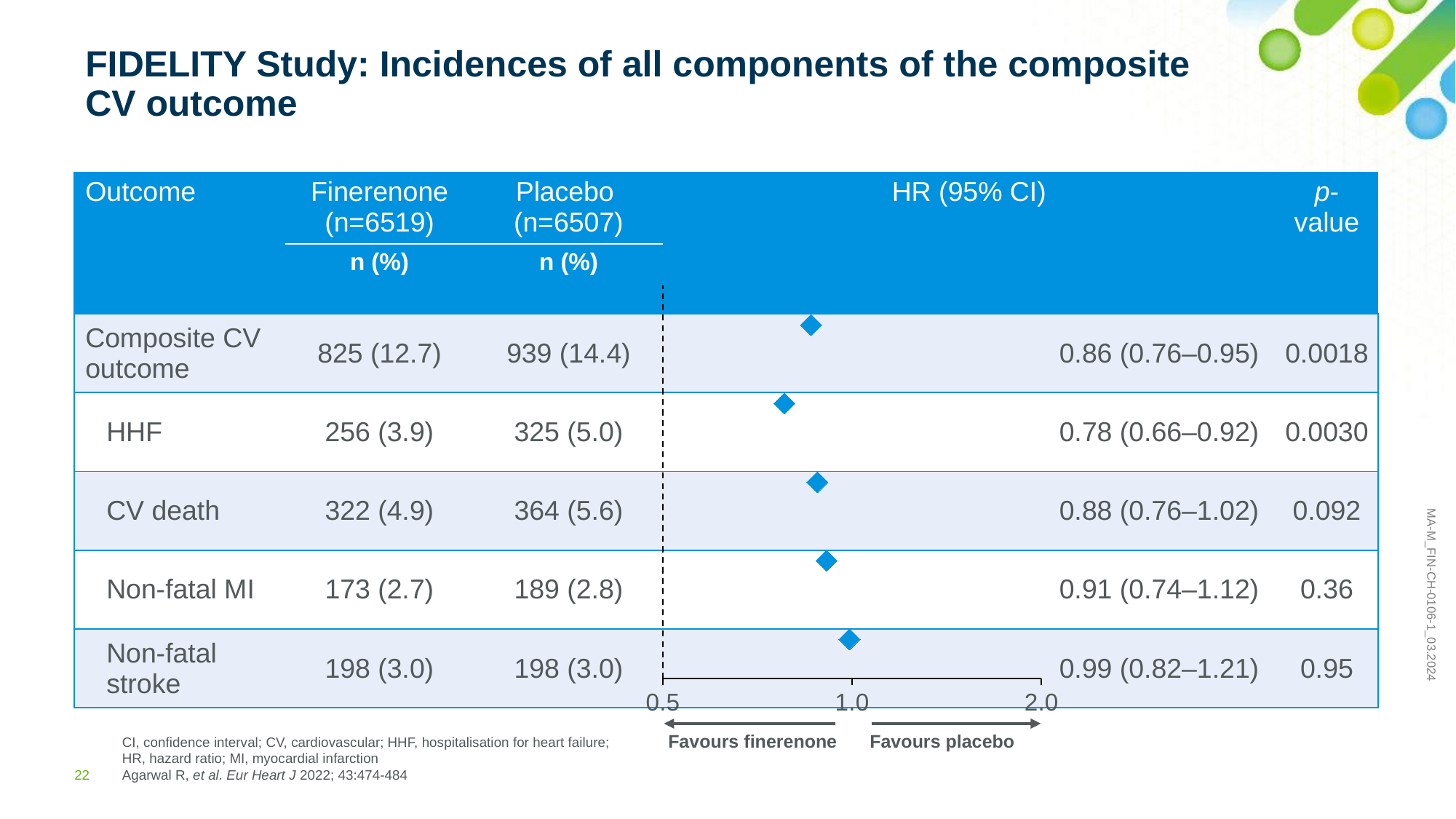
What kind of chart is shown in the HR (95% CI) column? forest plot What are the minimum and maximum tick values on the hazard ratio axis? 0.5 and 2.0 Is the hazard ratio for Composite CV outcome greater or less than 1.0? less What is the difference between the hazard ratio for CV death and the hazard ratio for HHF? 0.10 What is the hazard ratio (HR) plotted for HHF? 0.78 Which has the larger hazard ratio, Non-fatal MI or Composite CV outcome? Non-fatal MI According to the arrow labels under the axis, which direction favours finerenone? left (towards 0.5) Which outcome has the highest hazard ratio in the forest plot? Non-fatal stroke What is the hazard ratio (HR) plotted for Non-fatal stroke? 0.99 How many outcomes are plotted as points in the forest plot? 5 Which outcome has the lowest hazard ratio in the forest plot? HHF What is the 95% CI shown for CV death? 0.76–1.02